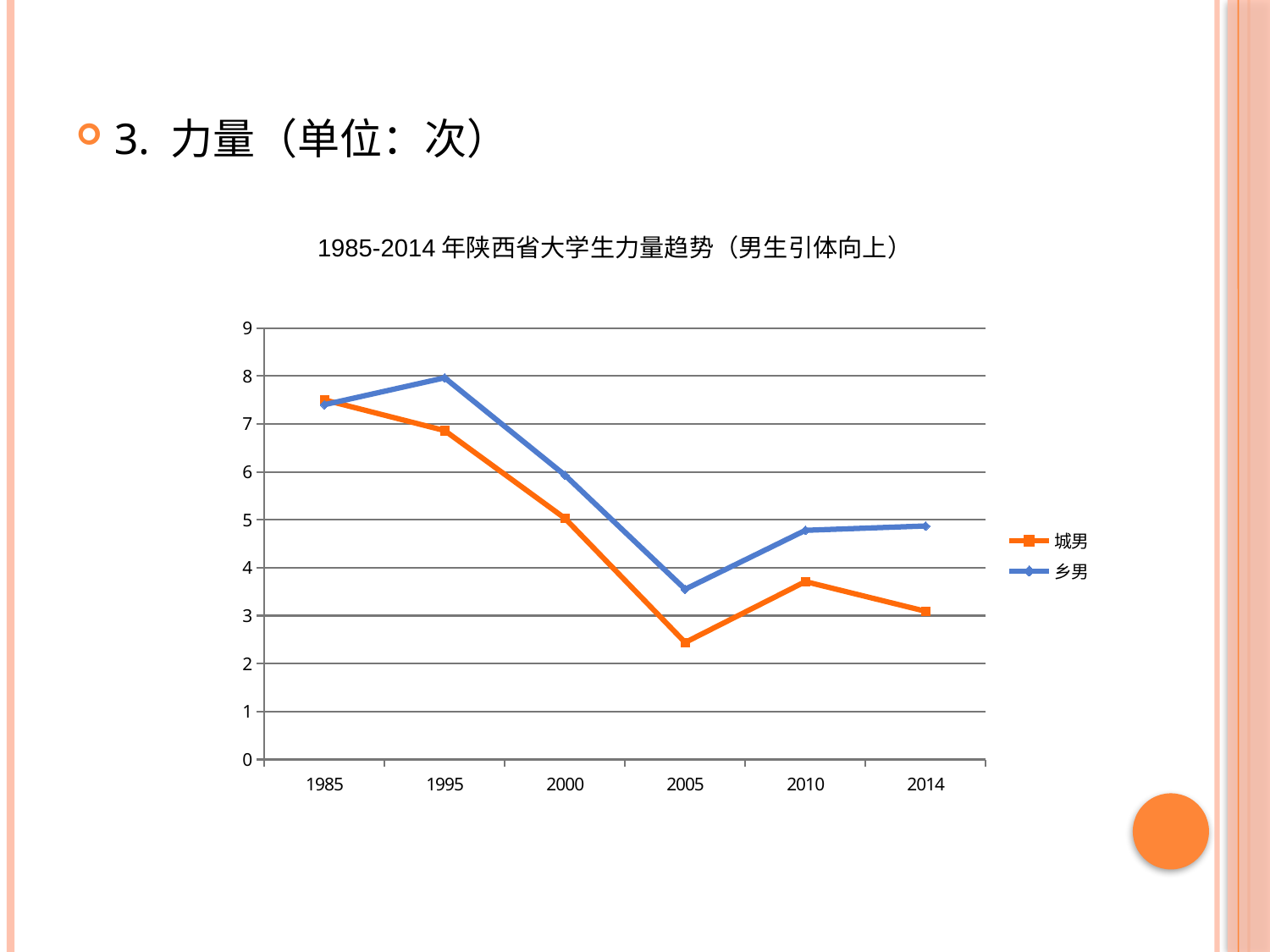
Is the value for 城男 in 2005 greater or less than 3? less In 2014, which series has the larger value, 城男 or 乡男? 乡男 Is the value for 乡男 in 2010 greater or less than 4? greater What kind of chart is shown on the slide? line chart Does the value for 城男 rise or fall from 1985 to 2005? fall In 2005, which series has the larger value, 城男 or 乡男? 乡男 What is the title of the chart? 1985-2014 年陕西省大学生力量趋势（男生引体向上） In which year is the value for 乡男 highest? 1995 In which year is the value for 城男 lowest? 2005 Is the value for 城男 in 1995 greater or less than 7? less How many years are plotted along the x axis? 6 How many series does the legend list? 2